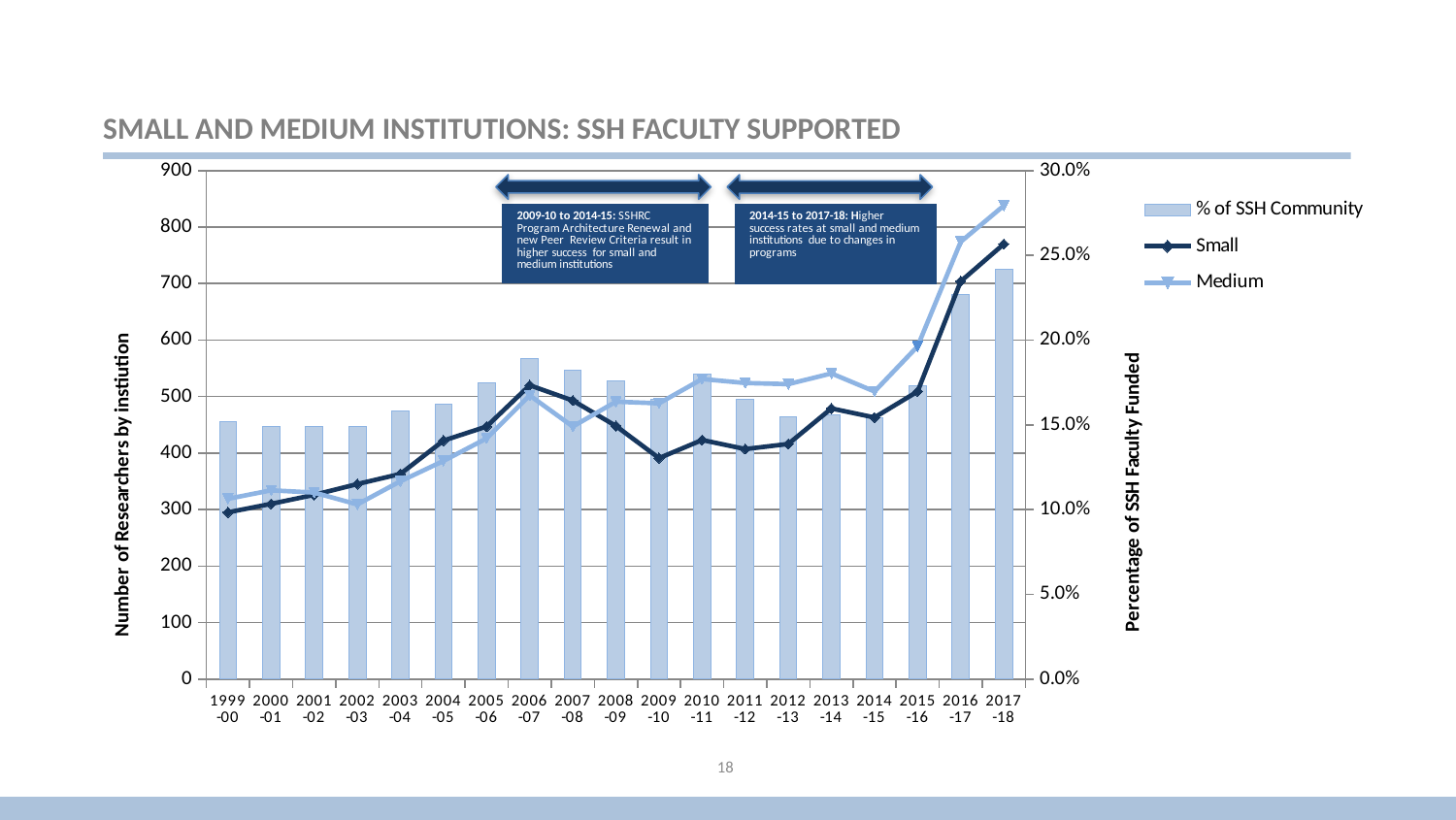
How many fiscal-year categories are shown along the x axis? 19 What is the title of the chart? SMALL AND MEDIUM INSTITUTIONS: SSH FACULTY SUPPORTED Which year has the tallest '% of SSH Community' bar? 2017-18 In which year does the Medium line reach its highest point? 2017-18 Read against the left axis, is the bar for 2017-18 greater or less than 700? greater Does the Small line rise or fall from 2014-15 to 2017-18? rise In 2009-10, which line is higher, Small or Medium? Medium How many series does the legend list? 3 In which year does the Small line reach its highest point? 2017-18 In 2007-08, which line is higher, Small or Medium? Small What kind of chart is shown on the slide? A combination bar and line chart What is the label on the right-hand vertical axis? Percentage of SSH Faculty Funded